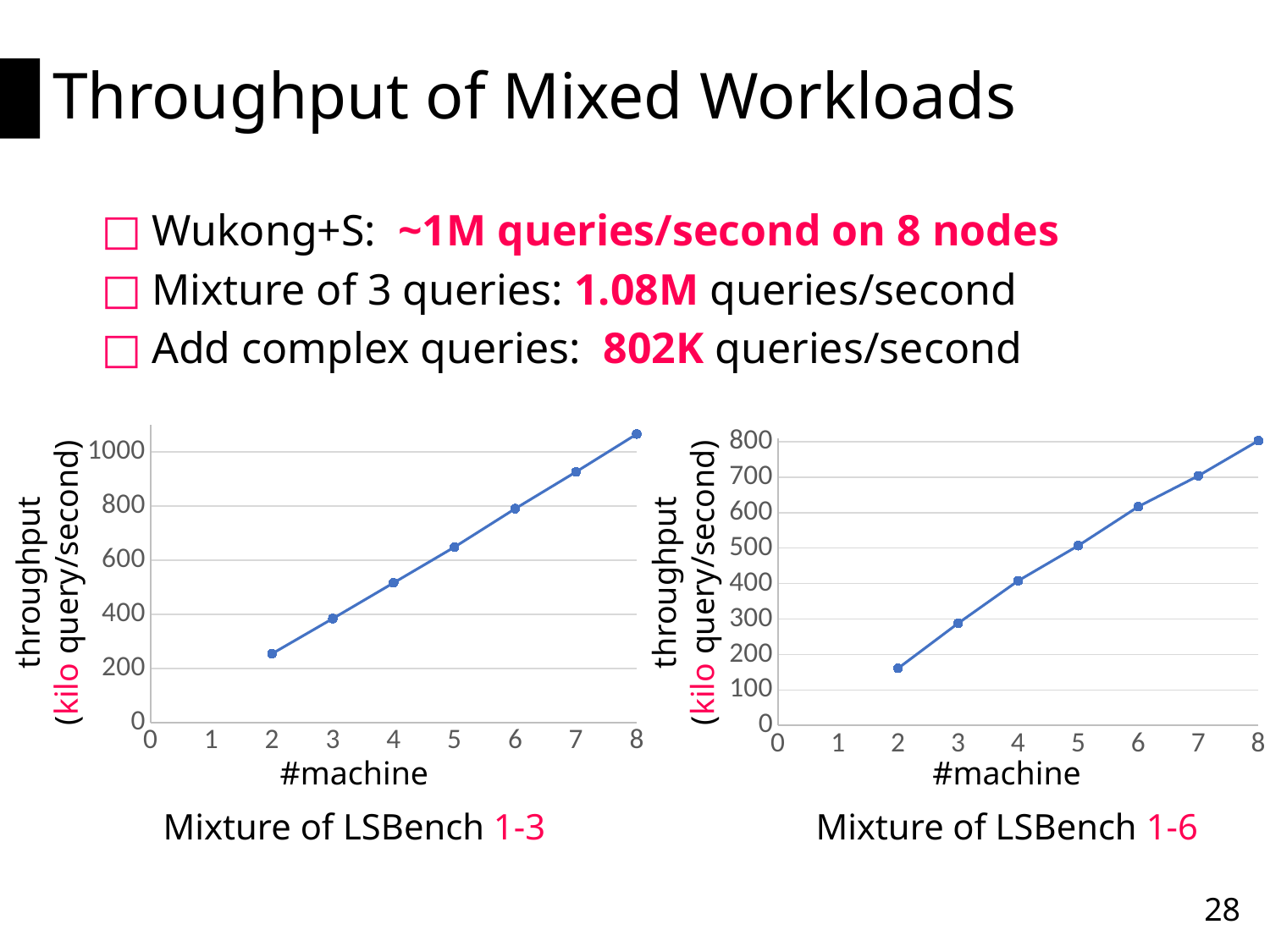
In the 'Mixture of LSBench 1-6' chart, at which number of machines is throughput lowest? 2 In the 'Mixture of LSBench 1-3' chart, at which number of machines is throughput highest? 8 What is the x-axis label of the 'Mixture of LSBench 1-6' chart? #machine In the 'Mixture of LSBench 1-3' chart, is the throughput at 8 machines greater or less than 1000? greater In the 'Mixture of LSBench 1-6' chart, how many data points are plotted? 7 In the 'Mixture of LSBench 1-3' chart, is the throughput at 2 machines greater or less than 400? less In the 'Mixture of LSBench 1-3' chart, does throughput rise or fall as the number of machines increases? rise What kind of chart is the 'Mixture of LSBench 1-3' chart on the left? line chart In the 'Mixture of LSBench 1-6' chart, does throughput rise or fall as the number of machines increases? rise In the 'Mixture of LSBench 1-6' chart, is the throughput at 2 machines greater or less than 200? less In the 'Mixture of LSBench 1-3' chart, how many data points are plotted? 7